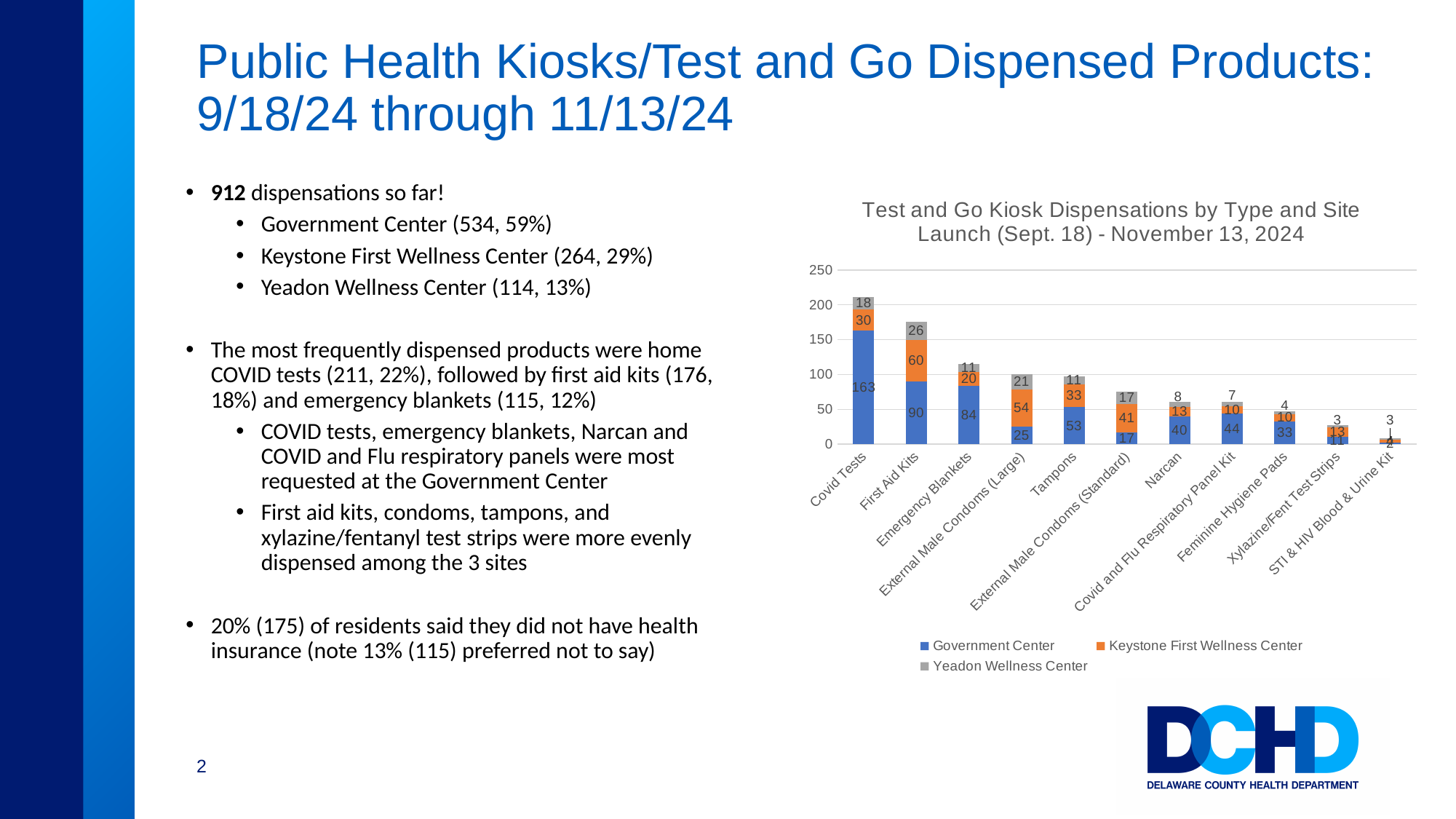
Is the total stacked bar for Emergency Blankets greater or less than 100? greater What is the Keystone First Wellness Center value for First Aid Kits? 60 How many product categories are shown on the x axis of the chart? 11 What is the difference between the Government Center value for Covid Tests and the Government Center value for First Aid Kits? 73 What type of chart is shown on the slide? stacked bar chart What is the total of the stacked bar for Tampons? 97 What is the Yeadon Wellness Center value for External Male Condoms (Large)? 21 What is the Government Center value for Covid Tests? 163 What is the total of the stacked bar for Narcan? 61 For External Male Condoms (Standard), which is larger: the Keystone First Wellness Center value or the Government Center value? Keystone First Wellness Center Which product category has the tallest stacked bar? Covid Tests How many series does the chart legend list? 3